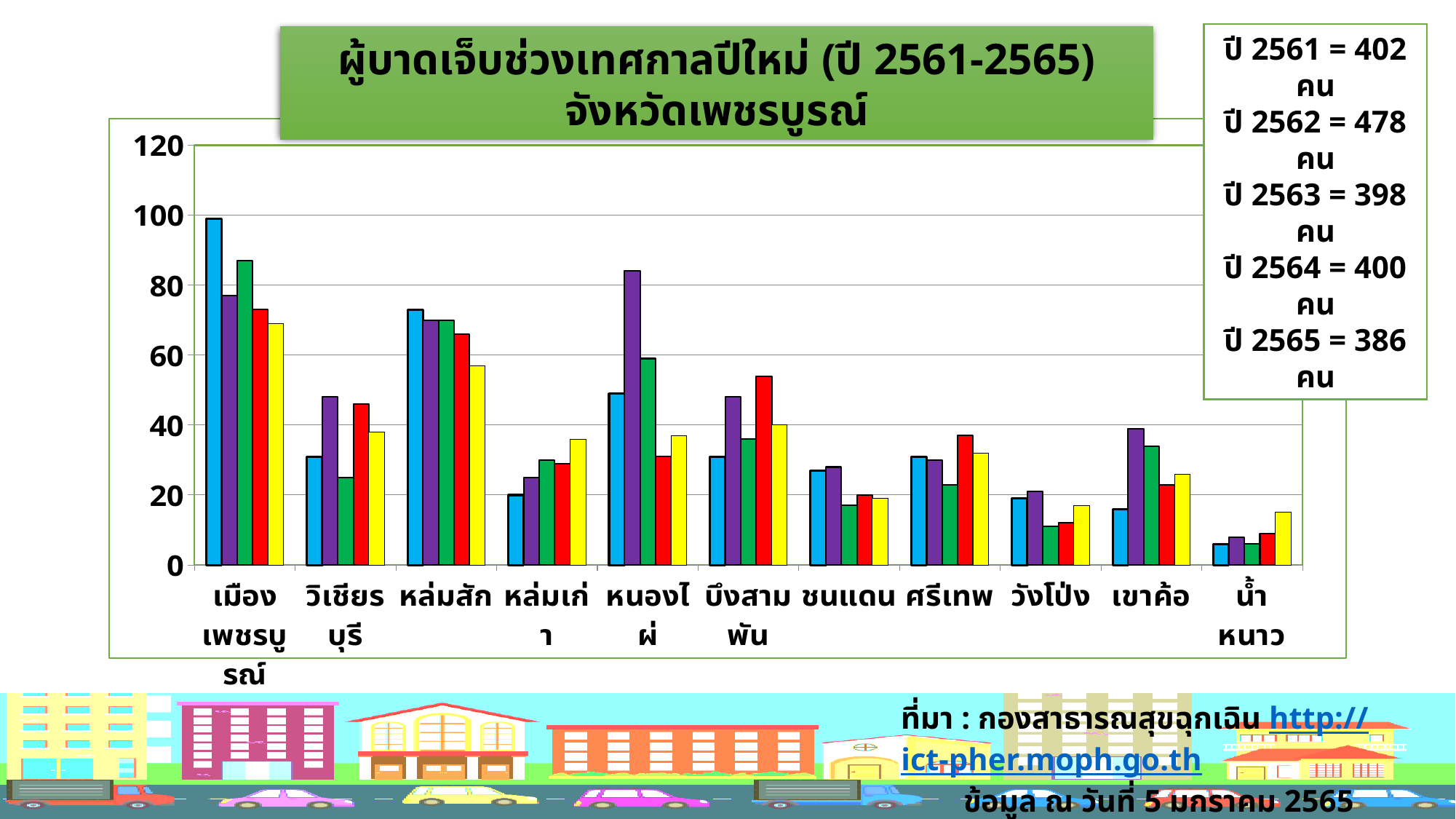
What kind of chart is shown on the slide? bar chart According to the text box beside the chart, how many injured people were there in ปี 2562? 478 คน Which is larger: the first (blue) bar for เมืองเพชรบูรณ์ or the first (blue) bar for หล่มสัก? เมืองเพชรบูรณ์ Is the value of the first (blue) bar for เมืองเพชรบูรณ์ greater or less than 80? greater Which district has the tallest bar in the chart? เมืองเพชรบูรณ์ How many districts (categories) are shown along the x axis of the chart? 11 What is the title of the chart? ผู้บาดเจ็บช่วงเทศกาลปีใหม่ (ปี 2561-2565) จังหวัดเพชรบูรณ์ Is the value of the first (blue) bar for หล่มสัก greater or less than 60? greater Is the value of the purple bar for หนองไผ่ greater or less than 80? greater Which district has the lowest bars overall in the chart? น้ำหนาว How many bars are plotted for each district in the chart? 5